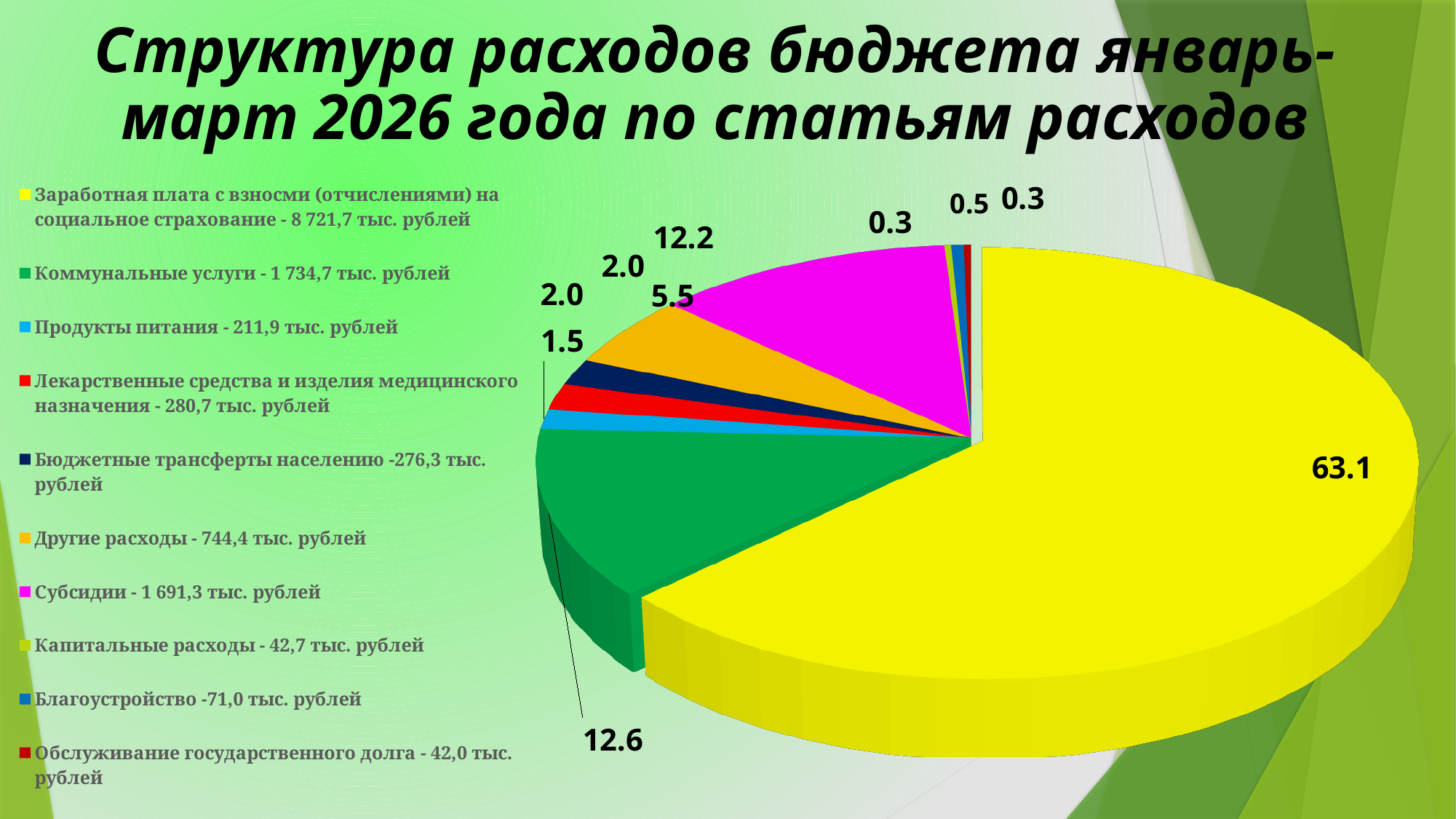
What colour is the slice for "Субсидии"? magenta What is the difference between the data labels for "Коммунальные услуги" and "Субсидии"? 0.4 What is the data label for the slice "Продукты питания"? 1.5 What is the data label for the slice "Коммунальные услуги"? 12.6 What is the data label for the slice "Другие расходы"? 5.5 Which category has the largest slice of the pie? Заработная плата с взносми (отчислениями) на социальное страхование What is the data label for the slice "Заработная плата с взносми (отчислениями) на социальное страхование"? 63.1 What is the data label for the slice "Субсидии"? 12.2 According to the legend, what amount in thousand rubles is given for "Коммунальные услуги"? 1 734,7 тыс. рублей Which slice is larger: "Другие расходы" or "Продукты питания"? Другие расходы What kind of chart is shown on the slide? pie chart How many categories does the legend of the pie chart list? 10